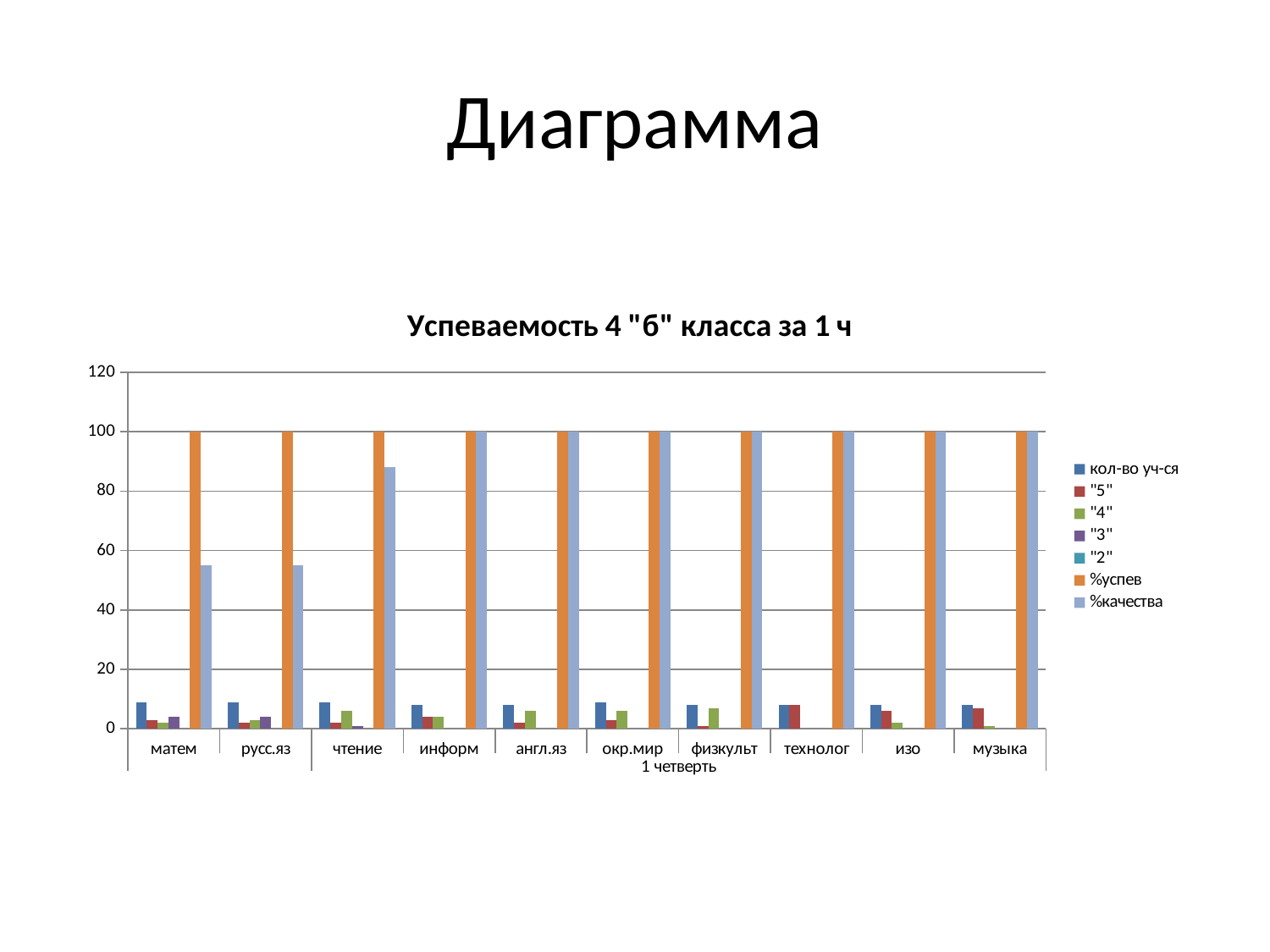
Is the value of %качества for чтение greater or less than 80? greater What is the title of the chart? Успеваемость 4 "б" класса за 1 ч How many subject categories are shown on the x axis of the chart? 10 Which has a larger %качества value: чтение or русс.яз? чтение Which has a larger %качества value: матем or информ? информ What is the value of %успев for музыка? 100 How many series does the chart legend list? 7 Is the value of %качества for матем greater or less than 60? less What kind of chart is shown on the slide? bar chart What label appears below the category names on the x axis? 1 четверть Is the value of кол-во уч-ся for матем greater or less than 20? less What is the value of %успев for матем? 100